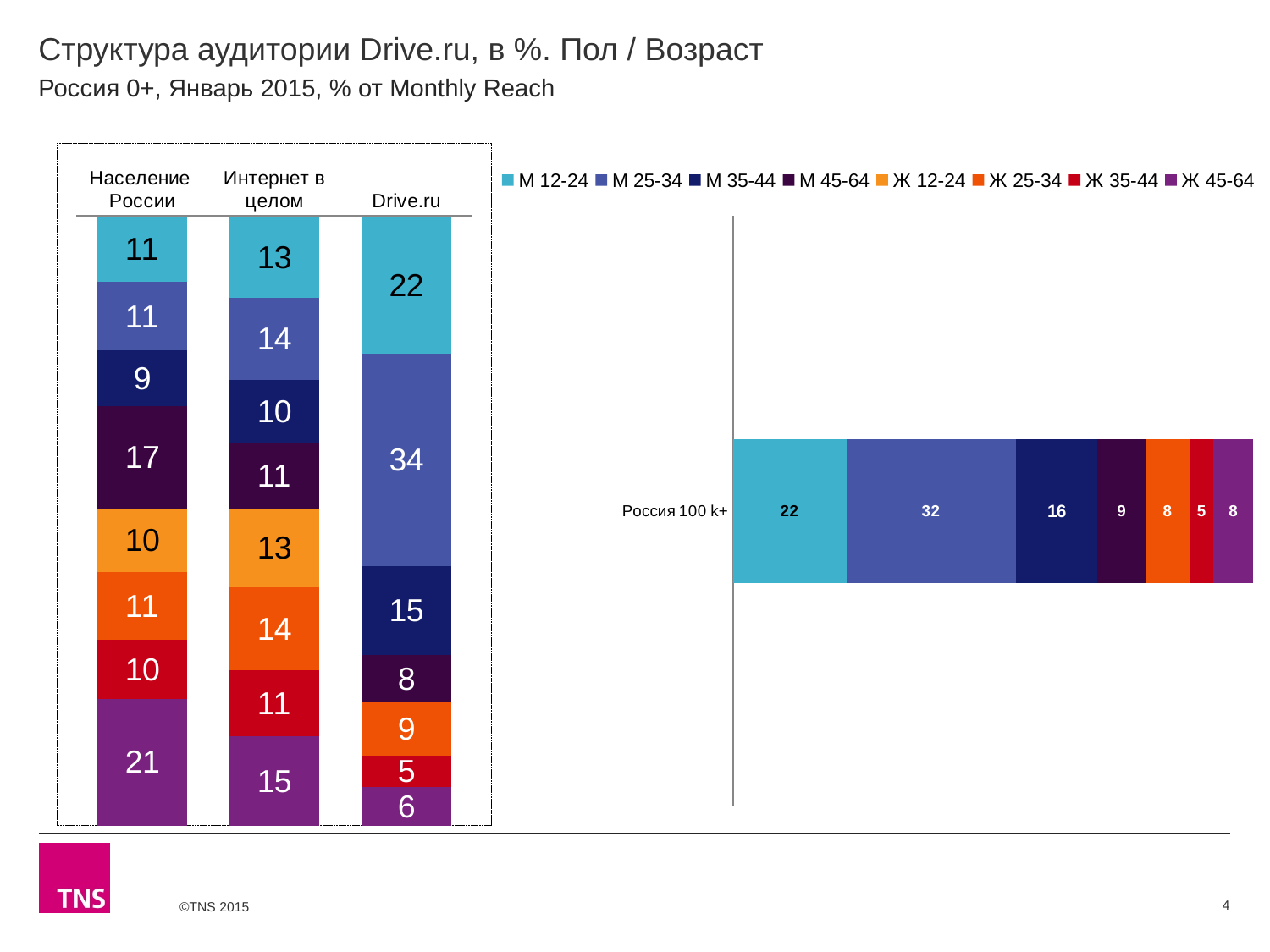
In the left chart, which is larger: the Ж 45-64 value for Население России or for Интернет в целом? Население России In the right chart (Россия 100 k+), what is the value of the М 25-34 segment? 32 What kind of chart is the right chart (Россия 100 k+)? Stacked bar chart In the left chart, what is the value of the М 35-44 segment for Интернет в целом? 10 In the left chart, what is the value of the М 25-34 segment for Drive.ru? 34 In the left chart, which segment is the largest in the Drive.ru bar? М 25-34 In the left chart, what is the difference between the М 25-34 values for Drive.ru and Население России? 23 How many series does the legend list? 8 How many bars are shown in the left chart? 3 In the left chart, what is the value of the Ж 45-64 segment for Население России? 21 In the left chart, which segment is the smallest in the Drive.ru bar? Ж 35-44 In the right chart (Россия 100 k+), which segment is the smallest? Ж 35-44